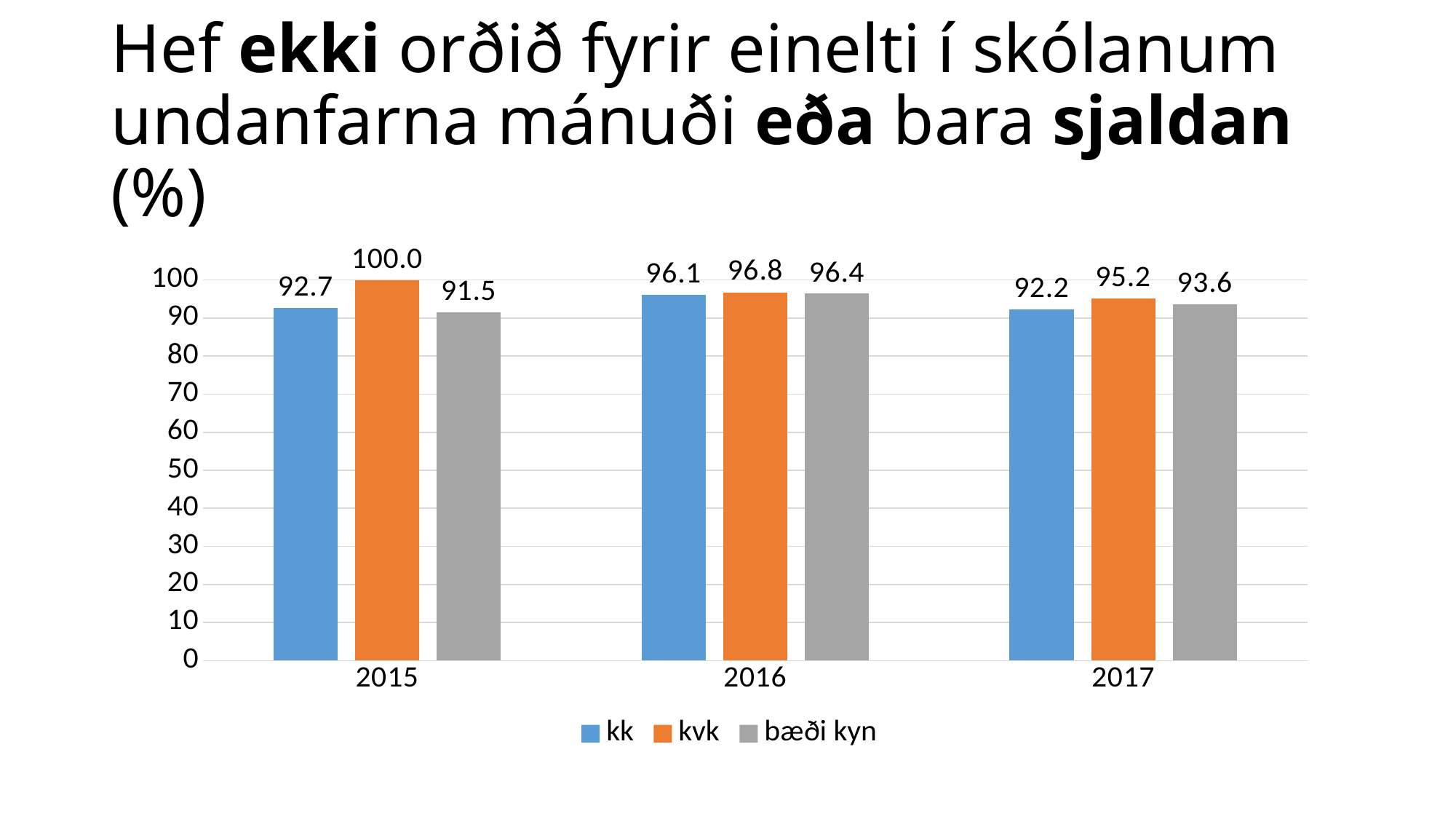
Which colour represents the kvk series? orange How many years are shown on the x axis? 3 What is the difference between the kvk and kk values in 2015? 7.3 In which year is the kk value highest? 2016 What is the value for kk in 2017? 92.2 Which is larger in 2017, the kvk value or the bæði kyn value? kvk What is the value for bæði kyn in 2016? 96.4 What is the value for kvk in 2015? 100.0 In which year is the bæði kyn value lowest? 2015 How many series does the legend list? 3 What kind of chart is shown on the slide? bar chart Is the value for kk in 2015 greater or less than 90? greater